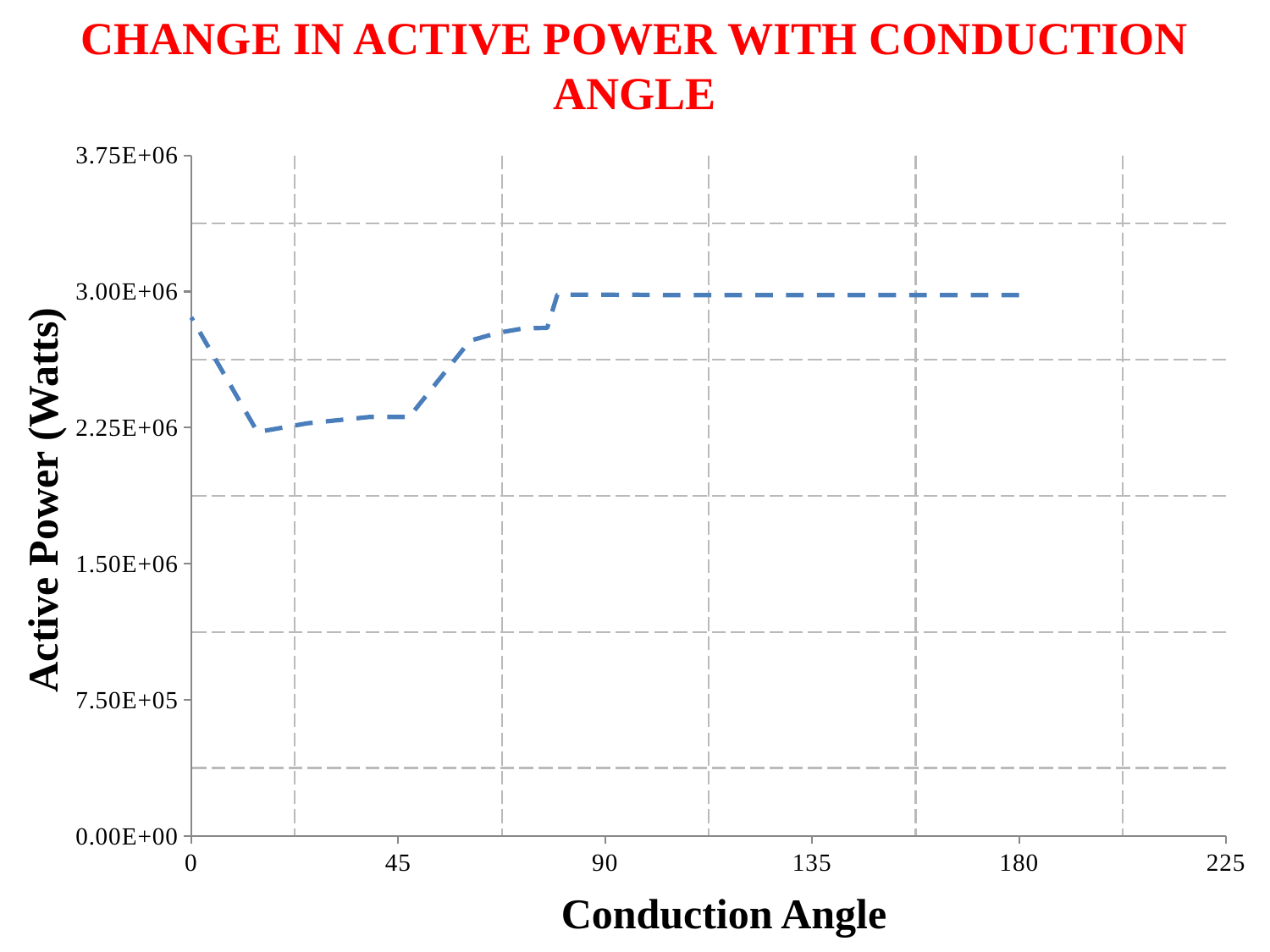
Is the lowest active power on the chart reached before or after a conduction angle of 45? before Does the active power rise or fall as the conduction angle increases from 45 to 90? rise Is the value for a conduction angle of 180 greater or less than 3.75E+06? less Which is larger, the active power at a conduction angle of 180 or at a conduction angle of 45? 180 What kind of chart is shown on the slide? line chart Does the active power rise or fall as the conduction angle increases from 0 to 15? fall Which is larger, the active power at a conduction angle of 0 or at a conduction angle of 45? 0 Is the value for a conduction angle of 135 greater or less than 2.25E+06? greater Is the value for a conduction angle of 0 greater or less than 2.25E+06? greater What is the label of the vertical axis? Active Power (Watts) What is the title of the chart? CHANGE IN ACTIVE POWER WITH CONDUCTION ANGLE